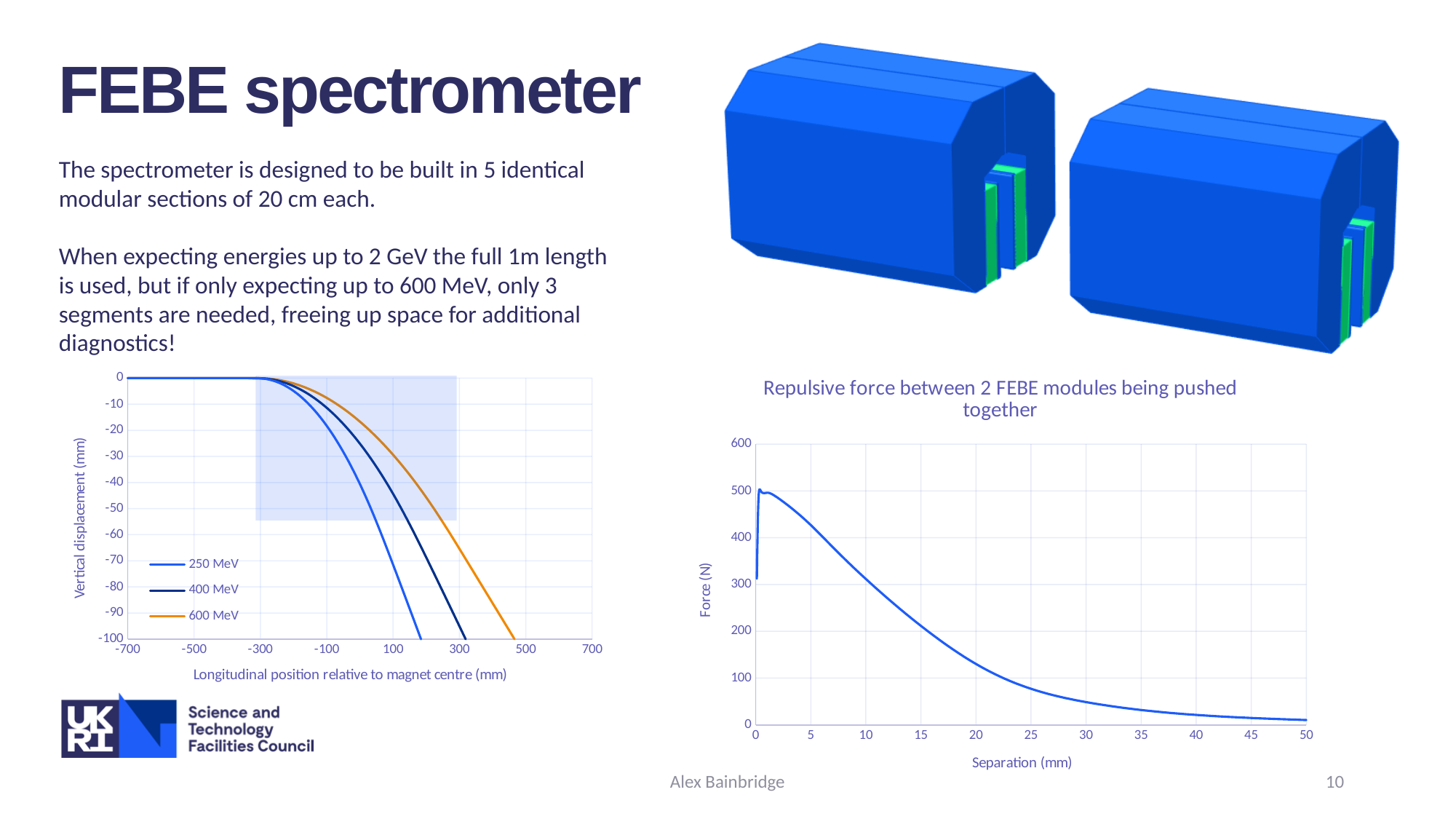
In the 'Repulsive force' chart, does the force rise or fall as separation increases from 5 mm to 50 mm? fall In the 'Repulsive force' chart, is the force at a separation of 30 mm greater or less than 100 N? less In the lower-left vertical displacement chart, which series reaches -100 mm at the smallest longitudinal position? 250 MeV What kind of chart is the 'Repulsive force between 2 FEBE modules being pushed together' chart? line chart In the lower-left vertical displacement chart, which series shows the smallest vertical displacement at a longitudinal position of 300 mm? 600 MeV What is the y-axis label of the lower-left chart? Vertical displacement (mm) How many series does the legend of the lower-left vertical displacement chart list? 3 In the 'Repulsive force' chart, is the peak force greater or less than 400 N? greater In the 'Repulsive force' chart, is the force at a separation of 20 mm greater or less than 100 N? greater In the lower-left vertical displacement chart, do the values rise or fall as the longitudinal position increases from -300 mm to 500 mm? fall What is the x-axis label of the 'Repulsive force' chart? Separation (mm) What kind of chart is the chart on the lower left showing vertical displacement against longitudinal position? line chart